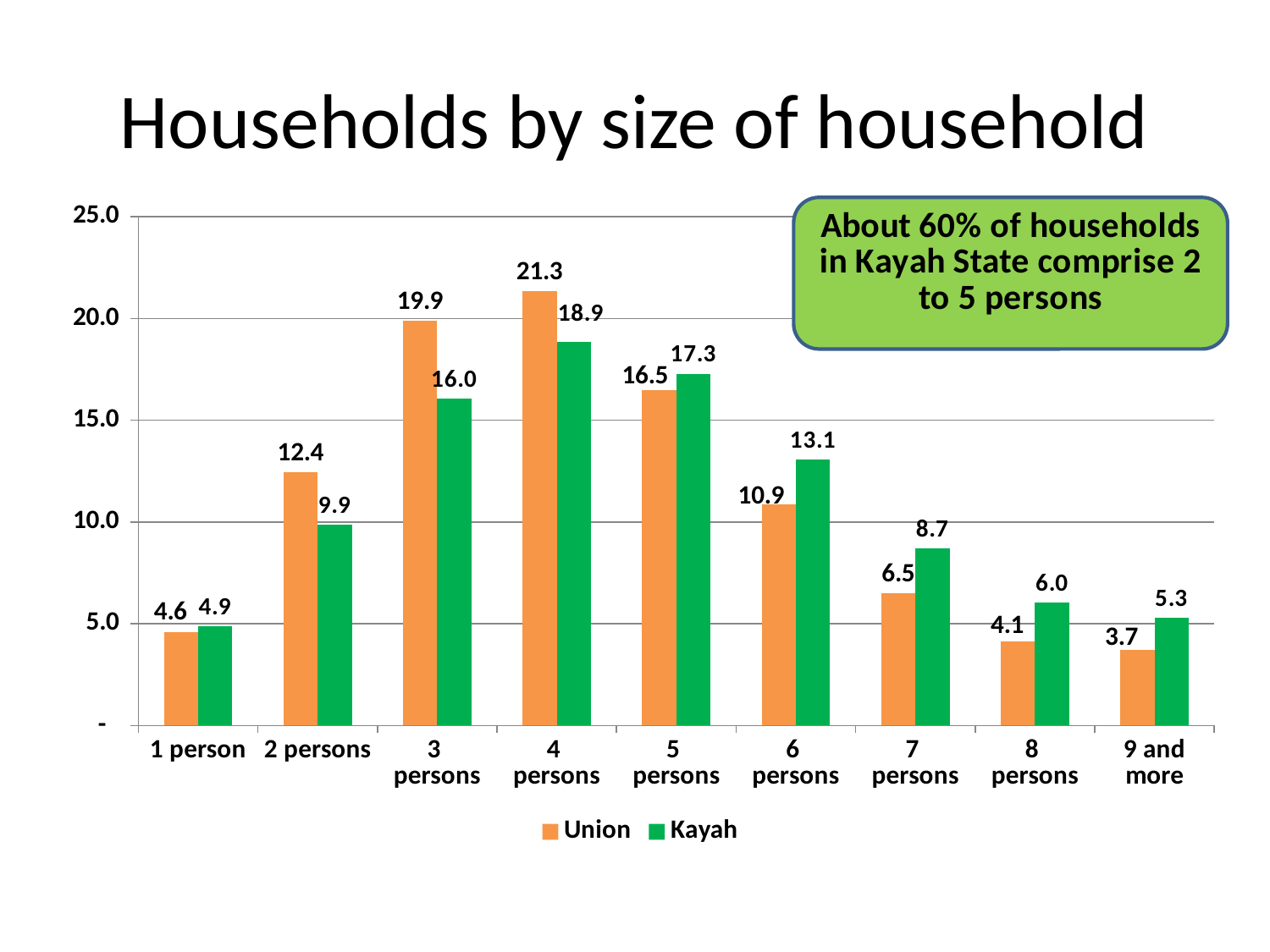
Is the Union value for 2 persons greater or less than 10.0? greater Which is larger for 7 persons, the Union value or the Kayah value? Kayah How many household size categories are shown on the x axis? 9 How many series does the legend list? 2 What is the difference between the Union and Kayah values for 3 persons? 3.9 Which household size has the lowest Union value? 9 and more What is the Kayah value for 9 and more? 5.3 What is the title of the slide? Households by size of household What kind of chart is shown on the slide? bar chart What is the Union value for 4 persons? 21.3 Which household size has the highest Kayah value? 4 persons What is the Kayah value for 6 persons? 13.1